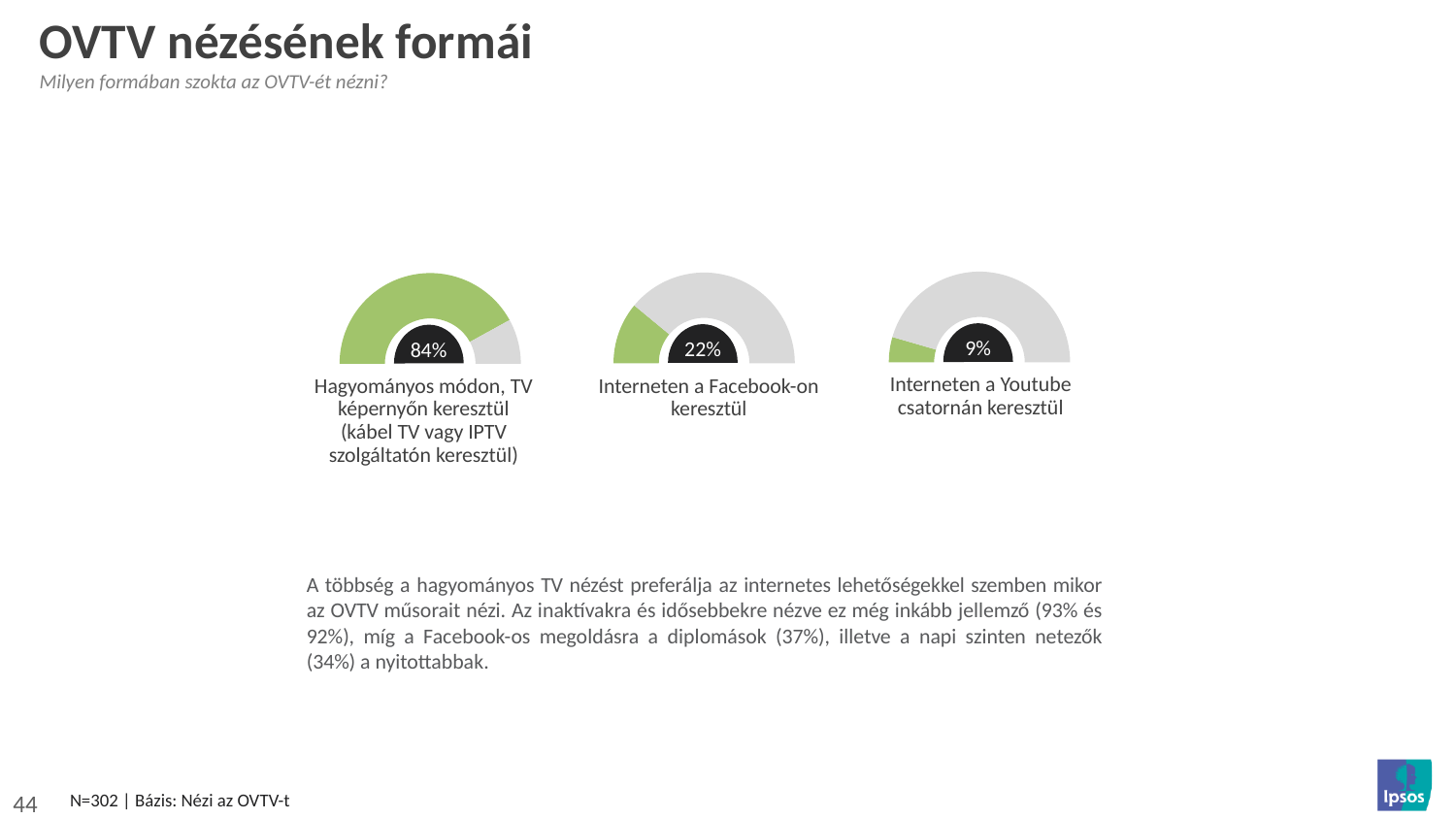
What is the difference in percentage points between traditional TV viewing (84%) and viewing via Facebook (22%)? 62 percentage points What percentage is shown for watching OVTV in the traditional way, on a TV screen (via cable TV or IPTV provider)? 84% What is the sample size (N) stated at the bottom of the slide? N=302 What is the difference in percentage points between viewing via Facebook (22%) and viewing via the Youtube channel (9%)? 13 percentage points What kind of chart is used to display each percentage on the slide? Semi-circular gauge (half-donut) chart What colour is used for the filled portion of each gauge chart? Green How many viewing forms are shown as gauge charts on the slide? 3 What percentage is shown for watching OVTV on the internet via Facebook? 22% What percentage is shown for watching OVTV on the internet via the Youtube channel? 9% Which viewing form has the highest percentage on the slide? Hagyományos módon, TV képernyőn keresztül (kábel TV vagy IPTV szolgáltatón keresztül) Which viewing form has the lowest percentage on the slide? Interneten a Youtube csatornán keresztül Which is larger: the share for viewing via Facebook or the share for viewing via the Youtube channel? Interneten a Facebook-on keresztül